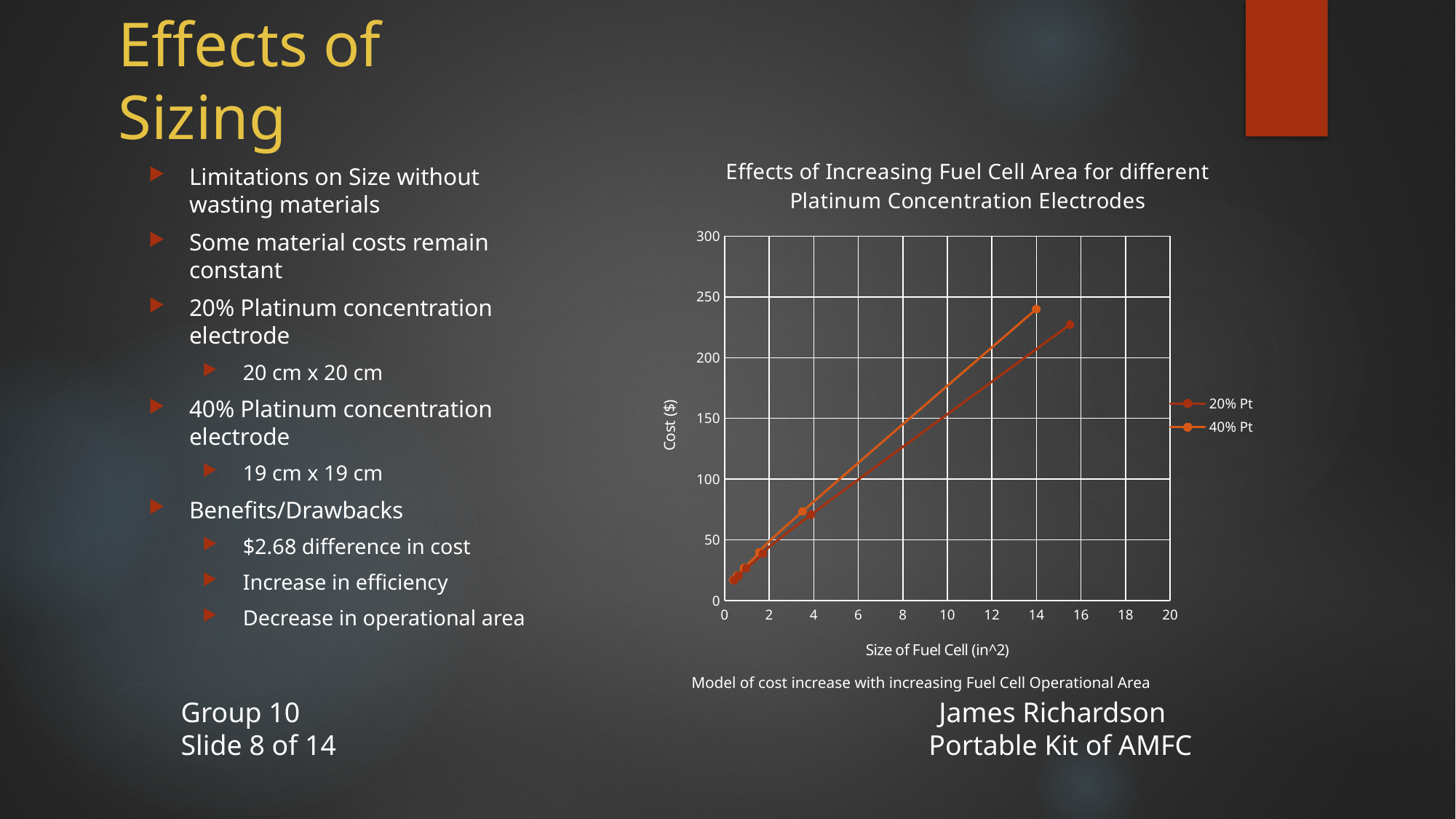
How many series does the chart legend list? 2 Which series reaches the highest cost value on the chart? 40% Pt What are the two series named in the chart legend? 20% Pt and 40% Pt At a fuel cell size of 14 in^2, which series shows the higher cost, 20% Pt or 40% Pt? 40% Pt What kind of chart is shown on the slide? Line chart Is the cost for the 20% Pt series at a size of 8 in^2 greater or less than 150? less Is the cost for the 20% Pt series at a size of 4 in^2 greater or less than 100? less What is the maximum value shown on the y axis of the chart? 300 Is the cost for the 40% Pt series at a size of 10 in^2 greater or less than 150? greater What is the label of the y axis of the chart? Cost ($) As the size of the fuel cell increases along the x axis, does the cost rise or fall? Rise